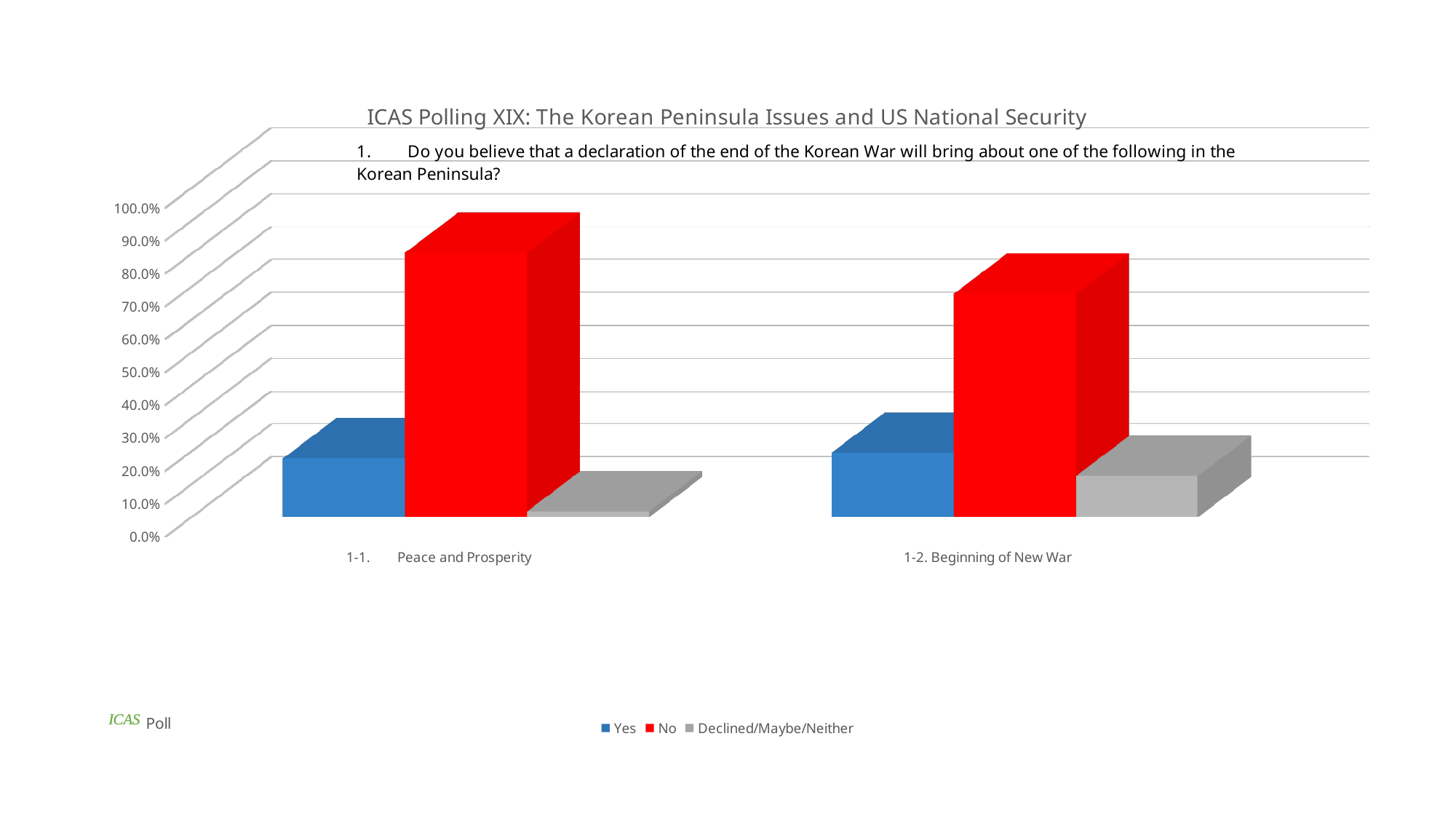
How many series does the legend list? 3 Which series has the highest value for 1-1. Peace and Prosperity? No Is the value for No in 1-2. Beginning of New War greater or less than 50.0%? greater What colour represents the No series in the legend? red Which series has the highest value for 1-2. Beginning of New War? No For 1-1. Peace and Prosperity, which is larger: Yes or No? No Which series has the lowest value for 1-1. Peace and Prosperity? Declined/Maybe/Neither What kind of chart is shown on the slide? bar chart Which series has the lowest value for 1-2. Beginning of New War? Declined/Maybe/Neither Is the value for Yes in 1-1. Peace and Prosperity greater or less than 40.0%? less How many categories are shown on the x axis? 2 Is the value for No in 1-1. Peace and Prosperity greater or less than 60.0%? greater